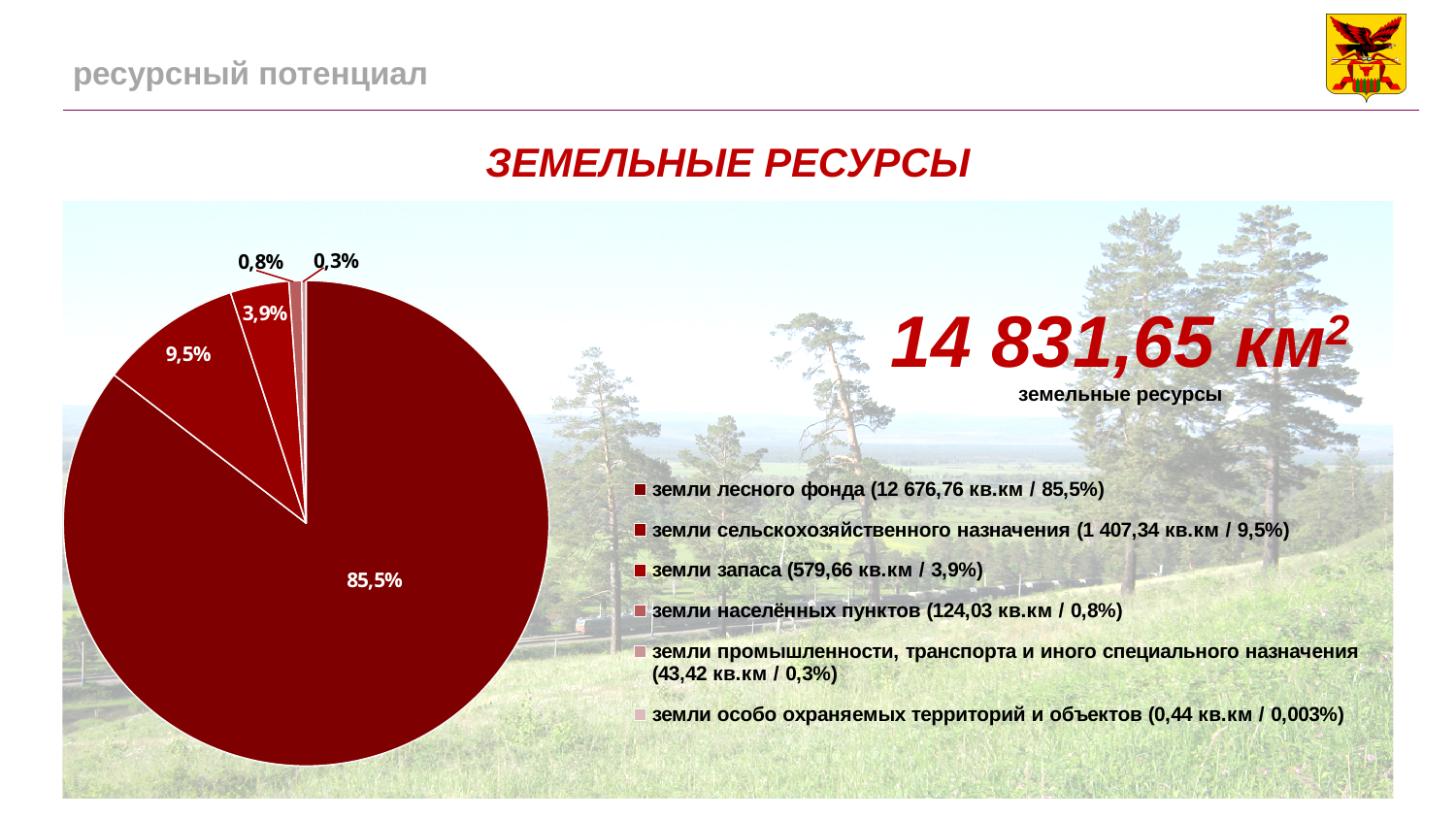
Which category has the largest slice of the pie? земли лесного фонда How many categories does the legend list? 6 What kind of chart is shown on the slide? pie chart What percentage is shown for земли запаса? 3,9% What percentage is shown for земли населённых пунктов? 0,8% Which category has the smallest share according to the legend? земли особо охраняемых территорий и объектов Which is larger: земли запаса or земли населённых пунктов? земли запаса What share of the pie is земли сельскохозяйственного назначения? 9,5% What total area of land resources is stated next to the chart? 14 831,65 км² What share of the pie is земли лесного фонда? 85,5% What is the difference in percentage points between земли лесного фонда and земли сельскохозяйственного назначения? 76% What area in кв.км is given for земли лесного фонда in the legend? 12 676,76 кв.км